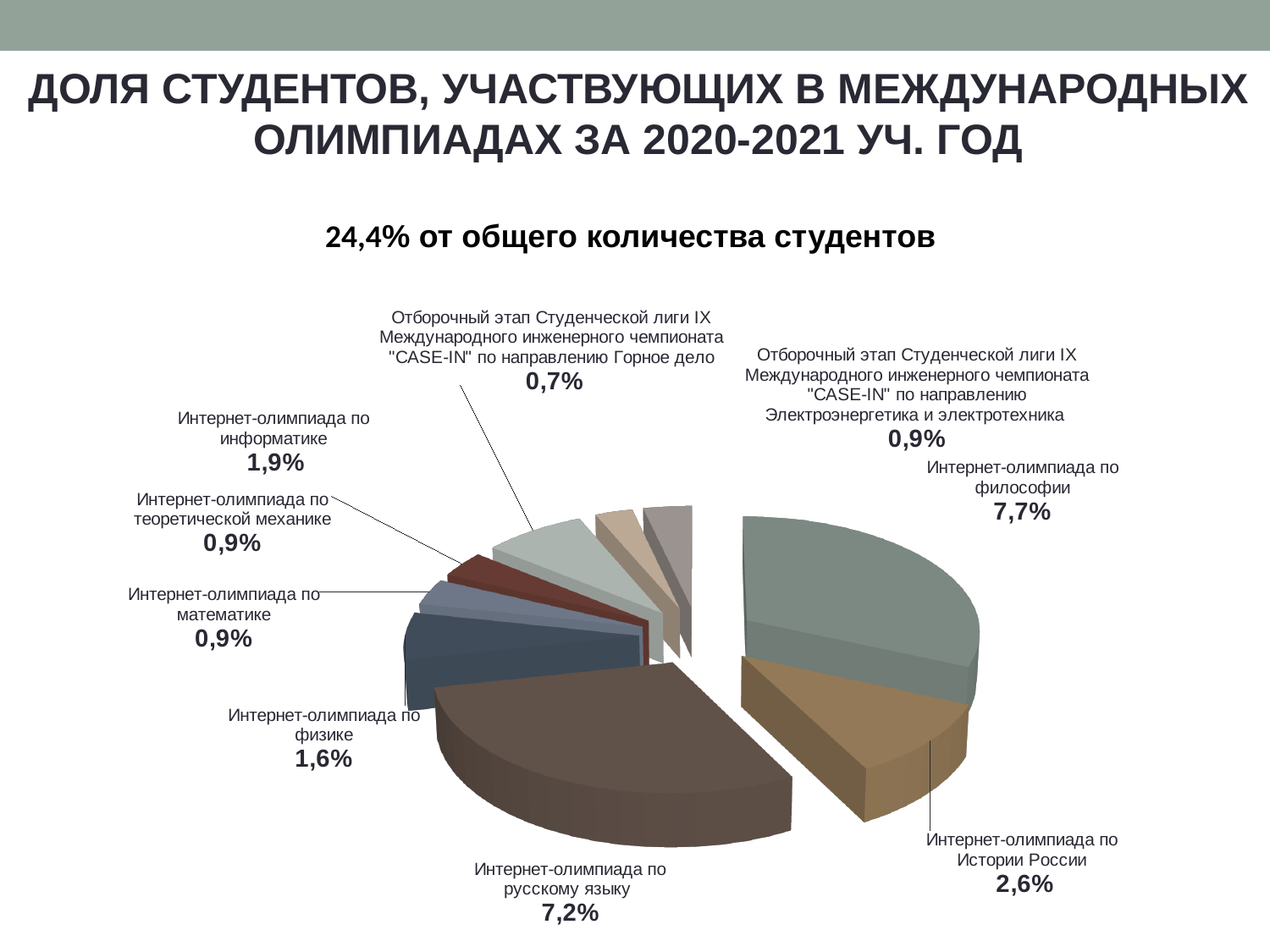
What kind of chart is shown on the slide? Pie chart Which is larger: the value for Интернет-олимпиада по Истории России or the value for Интернет-олимпиада по физике? Интернет-олимпиада по Истории России What is the difference between the values for Интернет-олимпиада по философии and Интернет-олимпиада по русскому языку? 0,5% According to the subtitle above the chart, what share of all students participated in international olympiads? 24,4% Which category has the largest value in the chart? Интернет-олимпиада по философии Which category has the smallest value in the chart? Отборочный этап Студенческой лиги IX Международного инженерного чемпионата "CASE-IN" по направлению Горное дело What is the value shown for Интернет-олимпиада по русскому языку? 7,2% What is the value shown for Интернет-олимпиада по Истории России? 2,6% What is the value shown for Интернет-олимпиада по философии? 7,7% What is the value shown for the Отборочный этап Студенческой лиги IX Международного инженерного чемпионата "CASE-IN" по направлению Горное дело? 0,7% What is the value shown for Интернет-олимпиада по информатике? 1,9% How many categories (slices) does the pie chart have? 9